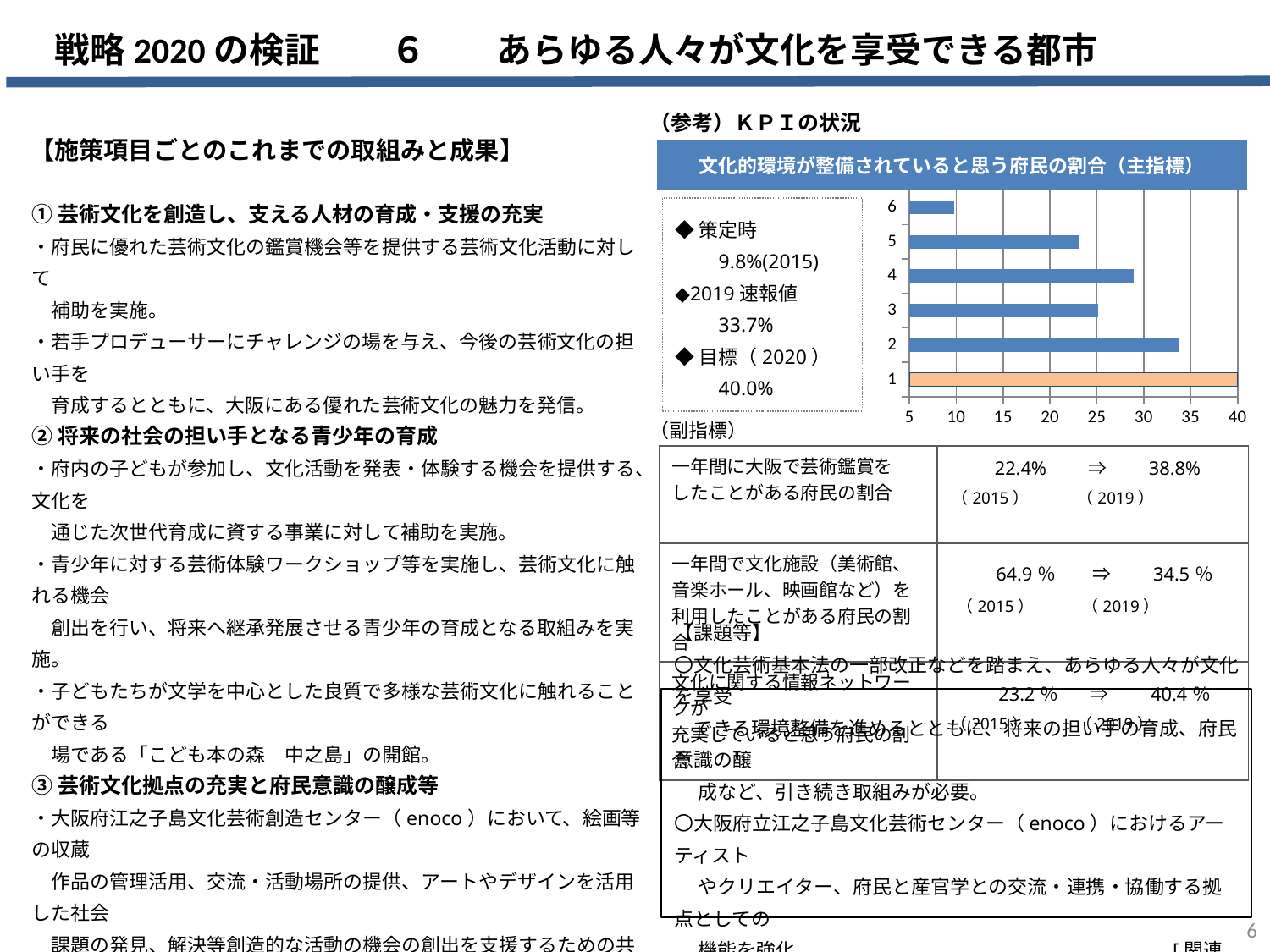
Which category has the shortest bar in the chart? 6 Is the value for category 3 greater or less than 30? less Which category has the longest bar in the chart? 1 Which has the larger value, category 4 or category 5? category 4 Which has the larger value, category 2 or category 3? category 2 Is the value for category 4 greater or less than 25? greater What kind of chart is shown under the heading 文化的環境が整備されていると思う府民の割合（主指標）? bar chart Is the value for category 5 greater or less than 20? greater Which category's bar is coloured orange rather than blue? 1 How many categories are plotted on the y axis of the bar chart? 6